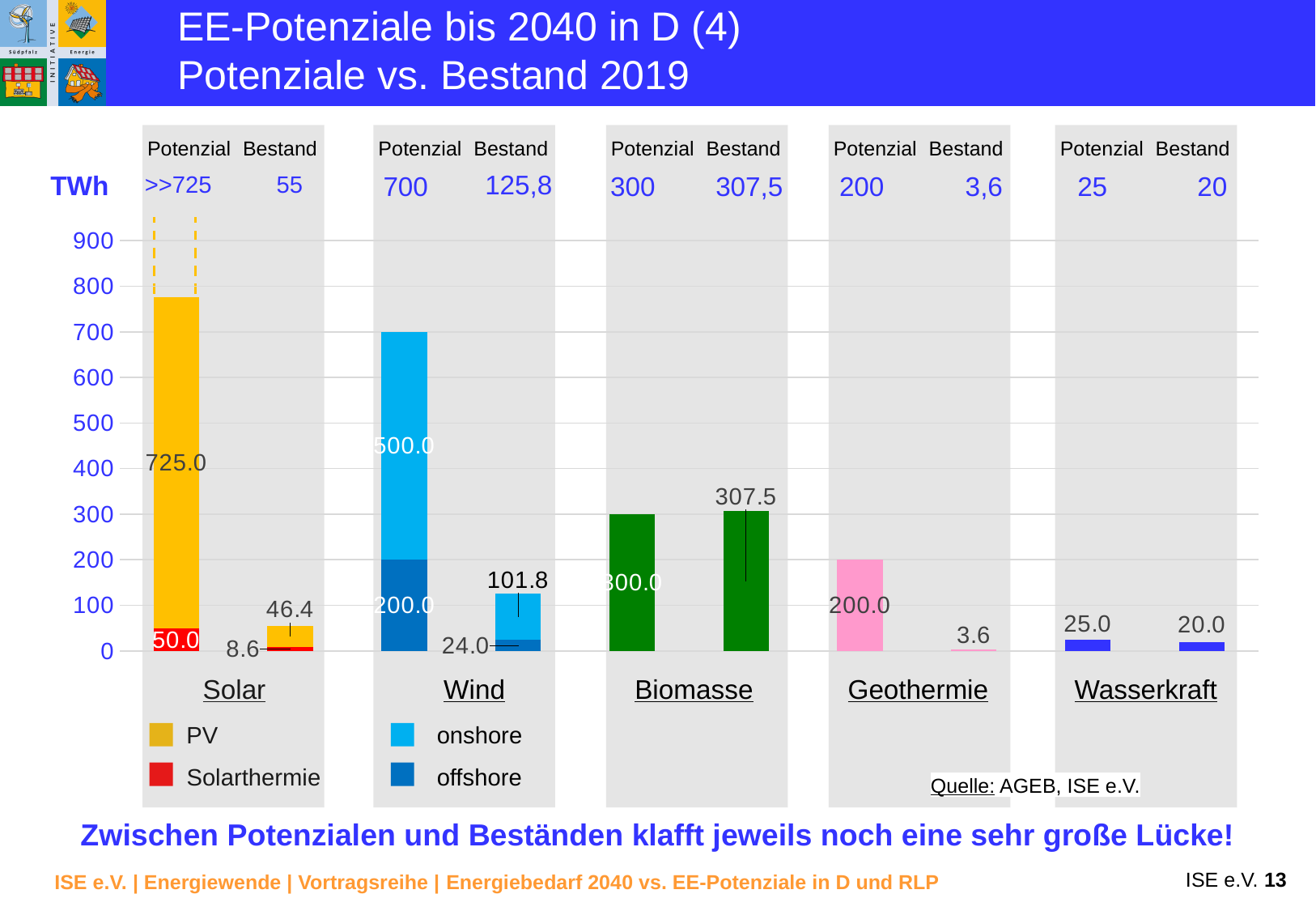
What is the data label on the PV segment of the Solar Potenzial bar? 725.0 What kind of chart is shown on the slide? bar chart What is the Bestand value shown for Geothermie? 3.6 Which is larger for Biomasse: the Potenzial bar or the Bestand bar? Bestand What is the total of the Wind Bestand stacked bar as printed in the header row? 125,8 What is the Bestand value shown for Biomasse? 307.5 What is the data label on the onshore segment of the Wind Potenzial bar? 500.0 What is the data label on the offshore segment of the Wind Bestand bar? 24.0 What is the difference between the Wasserkraft Potenzial (25.0) and Bestand (20.0) values? 5.0 What is the data label on the Solarthermie segment of the Solar Bestand bar? 8.6 Which energy source has the lowest Bestand value? Geothermie How many energy source groups are shown on the chart? 5